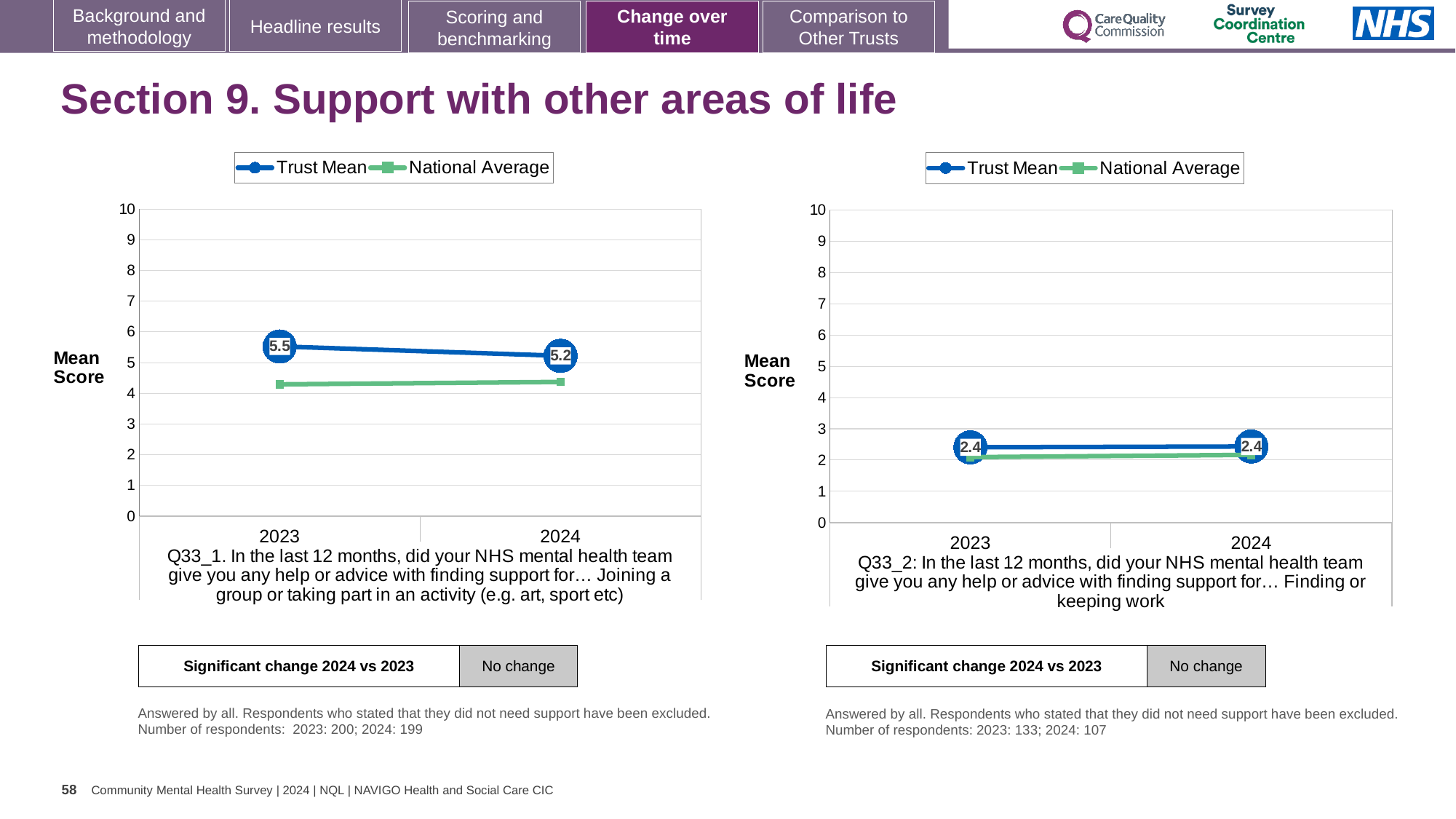
How many years are plotted on the x axis of the left chart (Q33_1)? 2 What kind of chart is the left chart (Q33_1)? line chart In the left chart (Q33_1), which is higher in 2024, the Trust Mean or the National Average? Trust Mean In the left chart (Q33_1), by how much did the Trust Mean change from 2023 to 2024? decreased by 0.3 In the right chart (Q33_2), does the Trust Mean rise, fall or stay the same from 2023 to 2024? stay the same In the right chart (Q33_2), is the Trust Mean for 2023 greater or less than 3? less In the left chart (Q33_1), what is the Trust Mean for 2024? 5.2 How many series does the legend of the right chart (Q33_2) list? 2 In the left chart (Q33_1), is the National Average for 2023 greater or less than 5? less In the left chart (Q33_1), what is the Trust Mean for 2023? 5.5 In the left chart (Q33_1), does the Trust Mean rise or fall from 2023 to 2024? fall In the right chart (Q33_2), what is the Trust Mean for 2024? 2.4